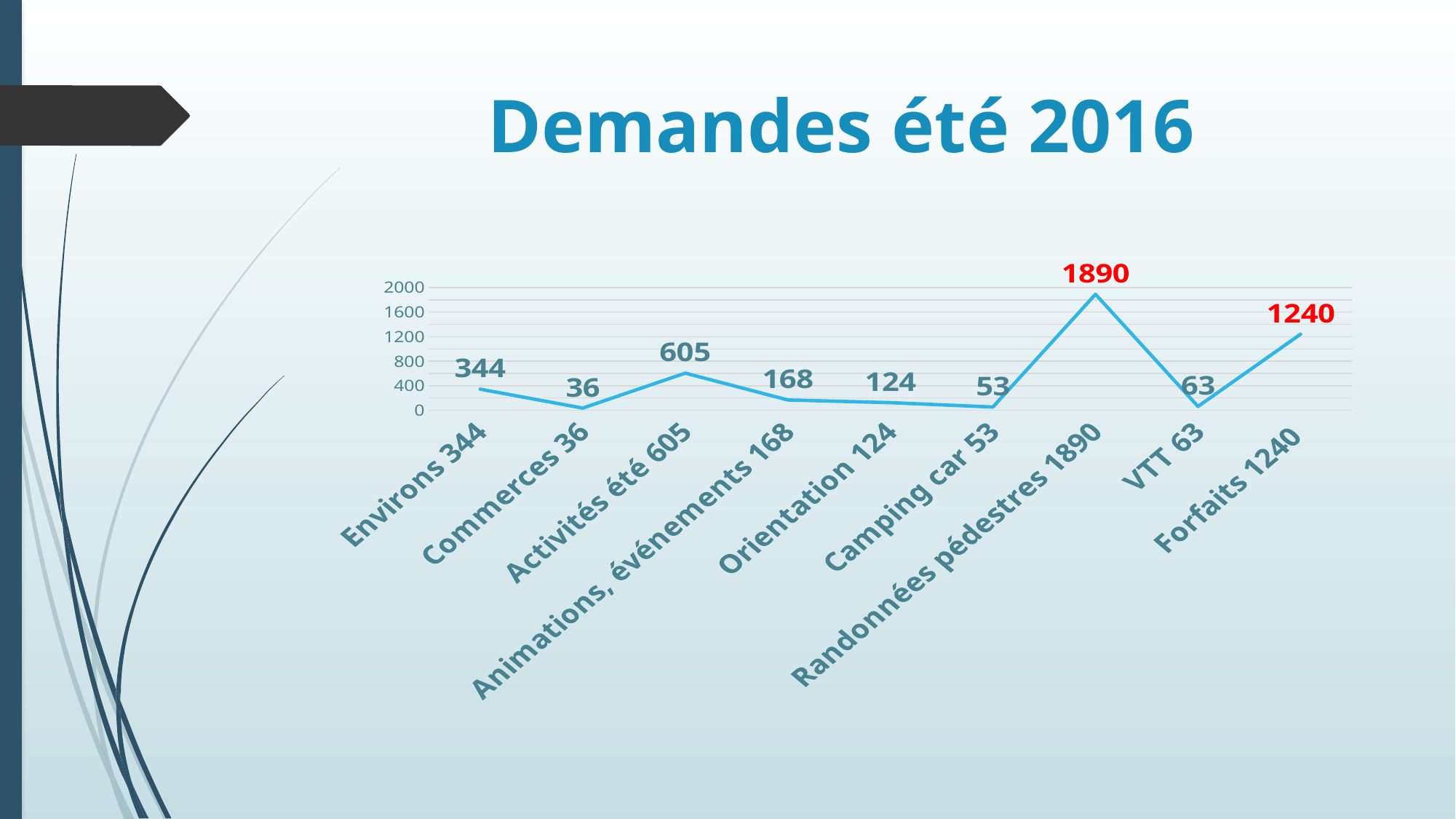
What is the title of the slide? Demandes été 2016 Is the value for Forfaits greater or less than 800? greater What is the value for Commerces? 36 What is the value for Randonnées pédestres? 1890 What is the value for Activités été? 605 Which category has the lowest value? Commerces What is the difference between the values for Randonnées pédestres and Forfaits? 650 How many categories are plotted on the chart? 9 What kind of chart is shown on the slide? line chart Which is larger, the value for VTT or the value for Camping car? VTT What is the difference between the values for Environs and Orientation? 220 Which category has the highest value? Randonnées pédestres